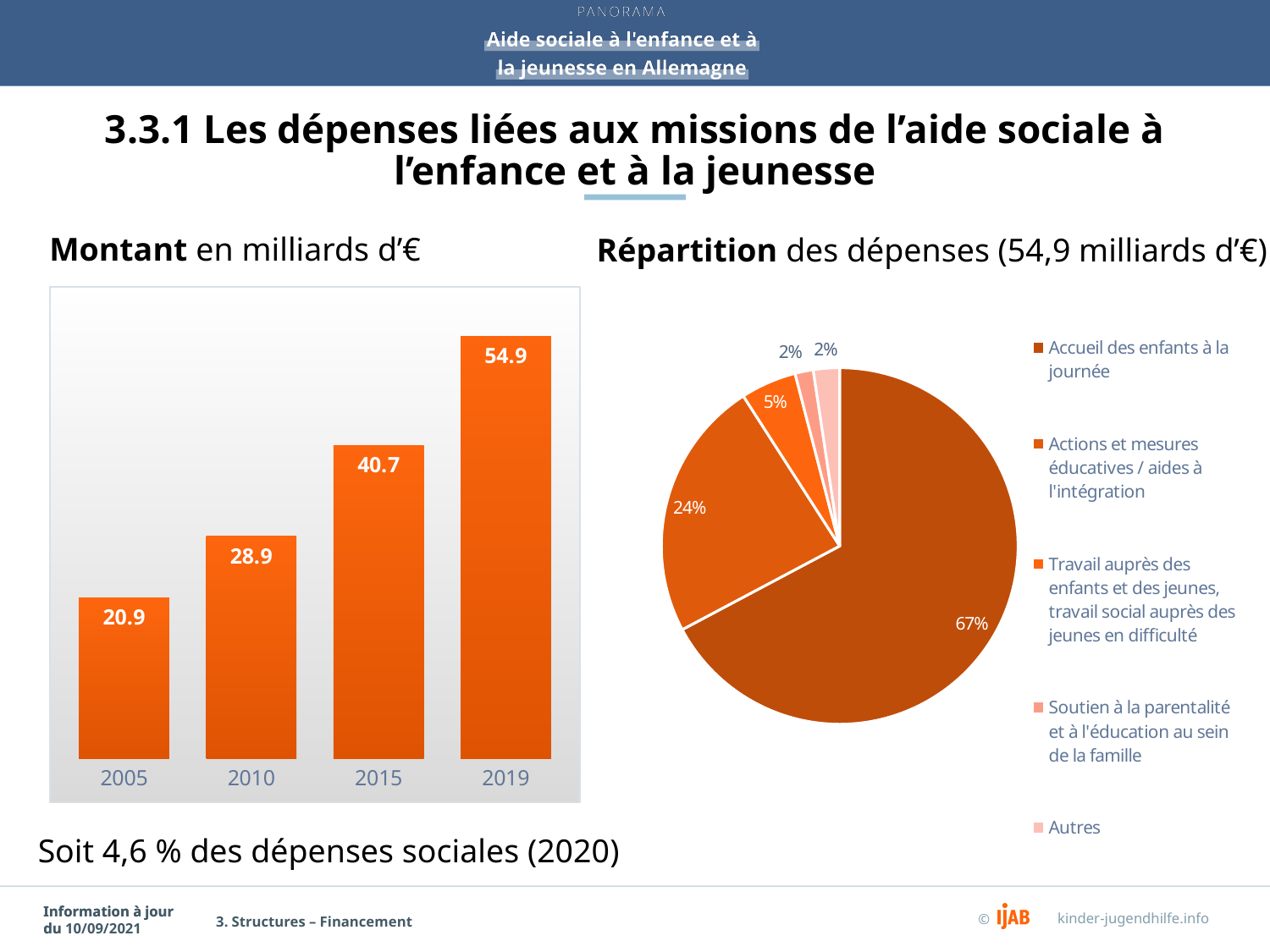
On the bar chart 'Montant en milliards d'€', what is the value for 2005? 20.9 On the bar chart 'Montant en milliards d'€', what is the difference between the values for 2019 and 2015? 14.2 On the bar chart 'Montant en milliards d'€', which year has the lowest value? 2005 On the pie chart 'Répartition des dépenses', what share is 'Actions et mesures éducatives / aides à l'intégration'? 24% On the pie chart 'Répartition des dépenses', how many categories does the legend list? 5 On the bar chart 'Montant en milliards d'€', which year has the highest value? 2019 On the bar chart 'Montant en milliards d'€', how many years are shown? 4 On the bar chart 'Montant en milliards d'€', do the values rise or fall from 2005 to 2019? rise What kind of chart is the one on the left of the slide? bar chart What kind of chart is the one on the right of the slide? pie chart On the bar chart 'Montant en milliards d'€', what is the value for 2019? 54.9 On the pie chart 'Répartition des dépenses', what share is 'Accueil des enfants à la journée'? 67%